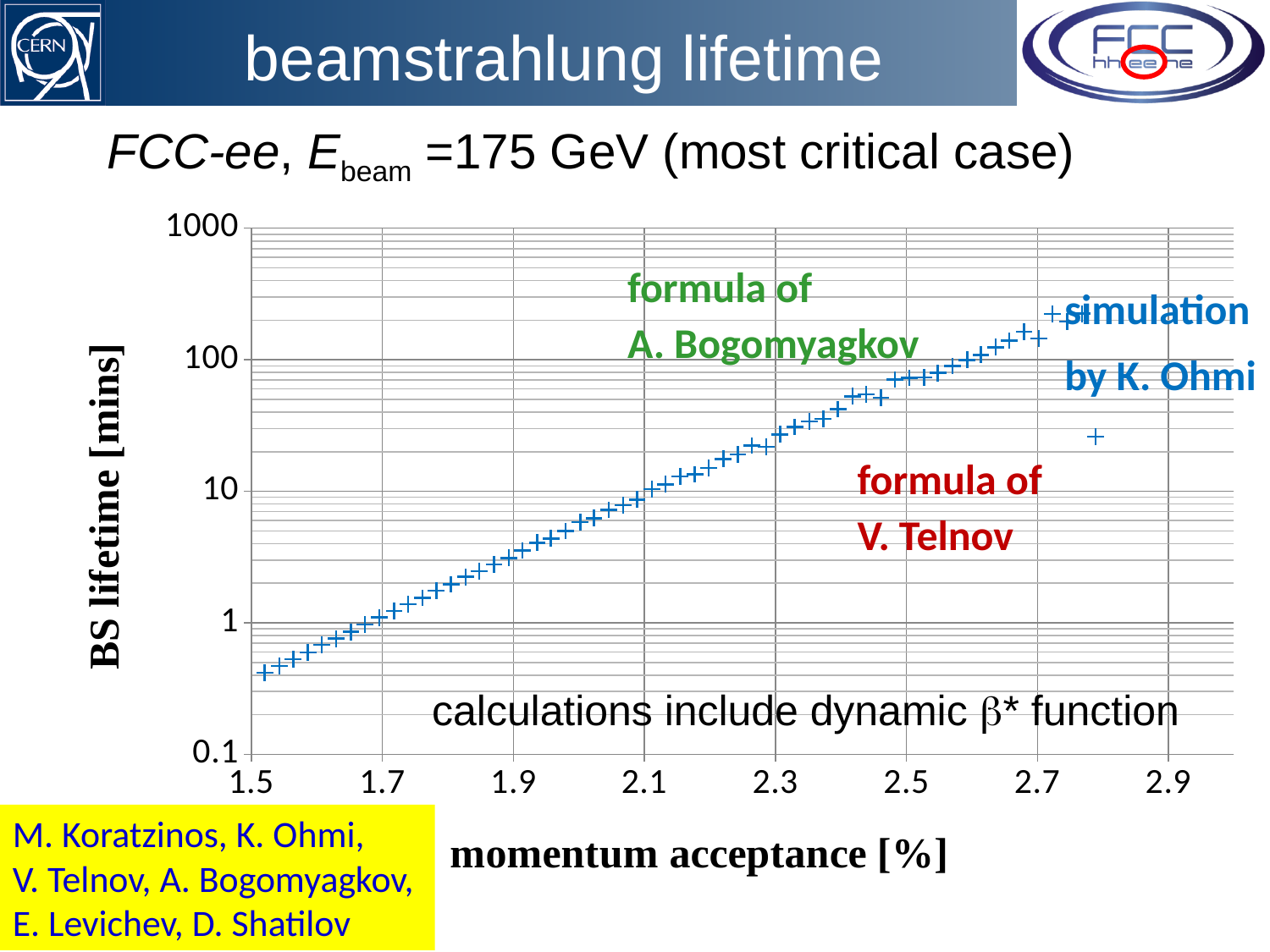
What is the label of the y axis of the chart? BS lifetime [mins] Is the BS lifetime at a momentum acceptance of 2.3% greater or less than 10 mins? greater Is the BS lifetime at a momentum acceptance of 1.5% greater or less than 1 min? less Do the plotted BS lifetime values rise or fall as momentum acceptance increases along the x axis? rise Is the isolated simulation point near a momentum acceptance of 2.8% greater or less than 100 mins? less Which has the larger BS lifetime: the point at momentum acceptance 1.7% or the point at 2.5%? 2.5% What is the label of the x axis of the chart? momentum acceptance [%] What kind of chart is shown on the slide? scatter chart